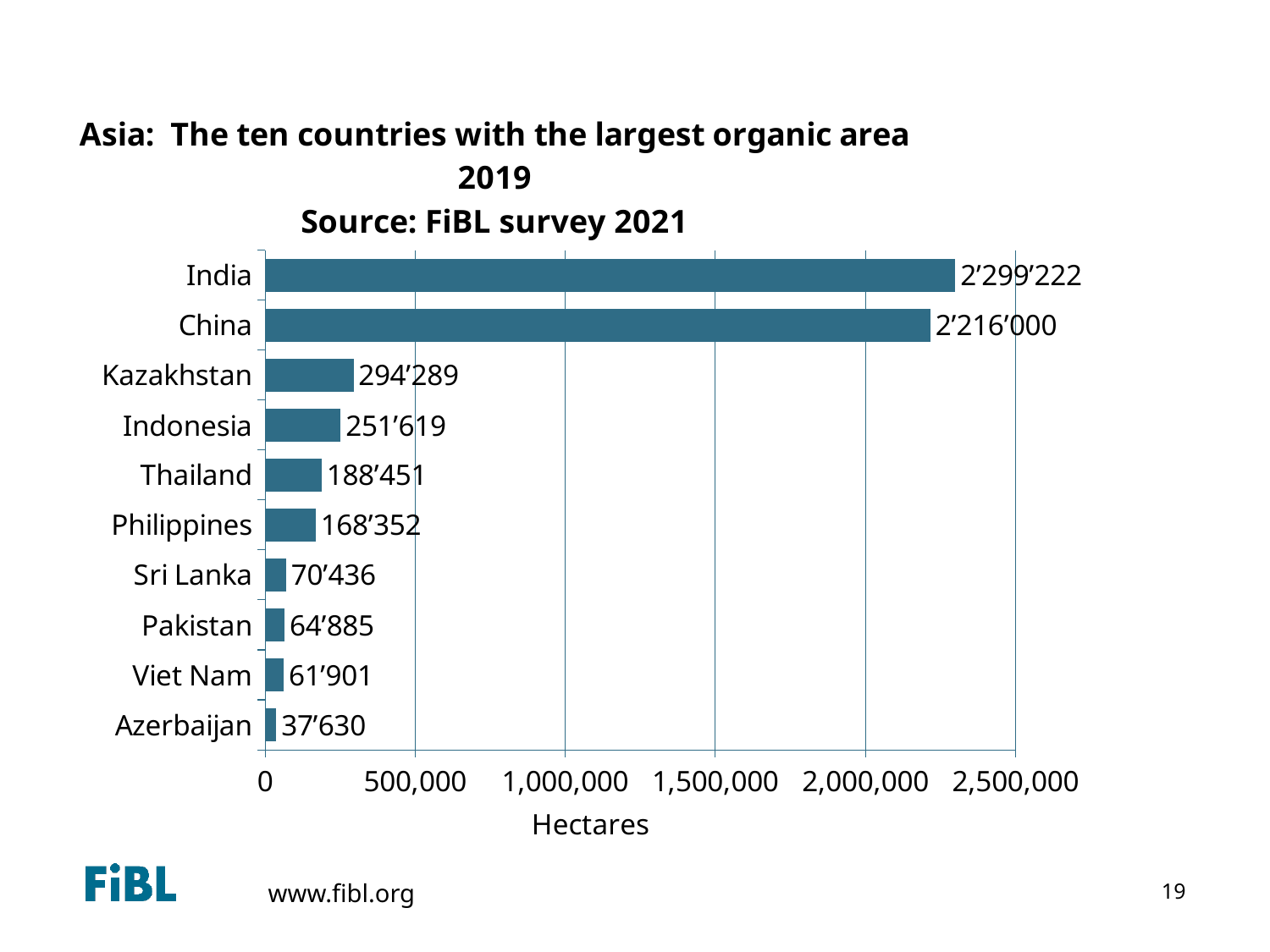
Which has a larger organic area, Indonesia or Thailand? Indonesia What is the difference in organic area between Thailand and the Philippines in hectares? 20’099 Which country has the largest organic area? India How many countries are shown in the chart? 10 What is the organic area of India in hectares? 2’299’222 What is the organic area of Kazakhstan in hectares? 294’289 What is the label of the horizontal axis? Hectares Is the value for China greater or less than 2,000,000? greater What is the organic area of Sri Lanka in hectares? 70’436 Which country has the smallest organic area? Azerbaijan What is the difference in organic area between India and China in hectares? 83’222 What kind of chart is shown on the slide? Bar chart